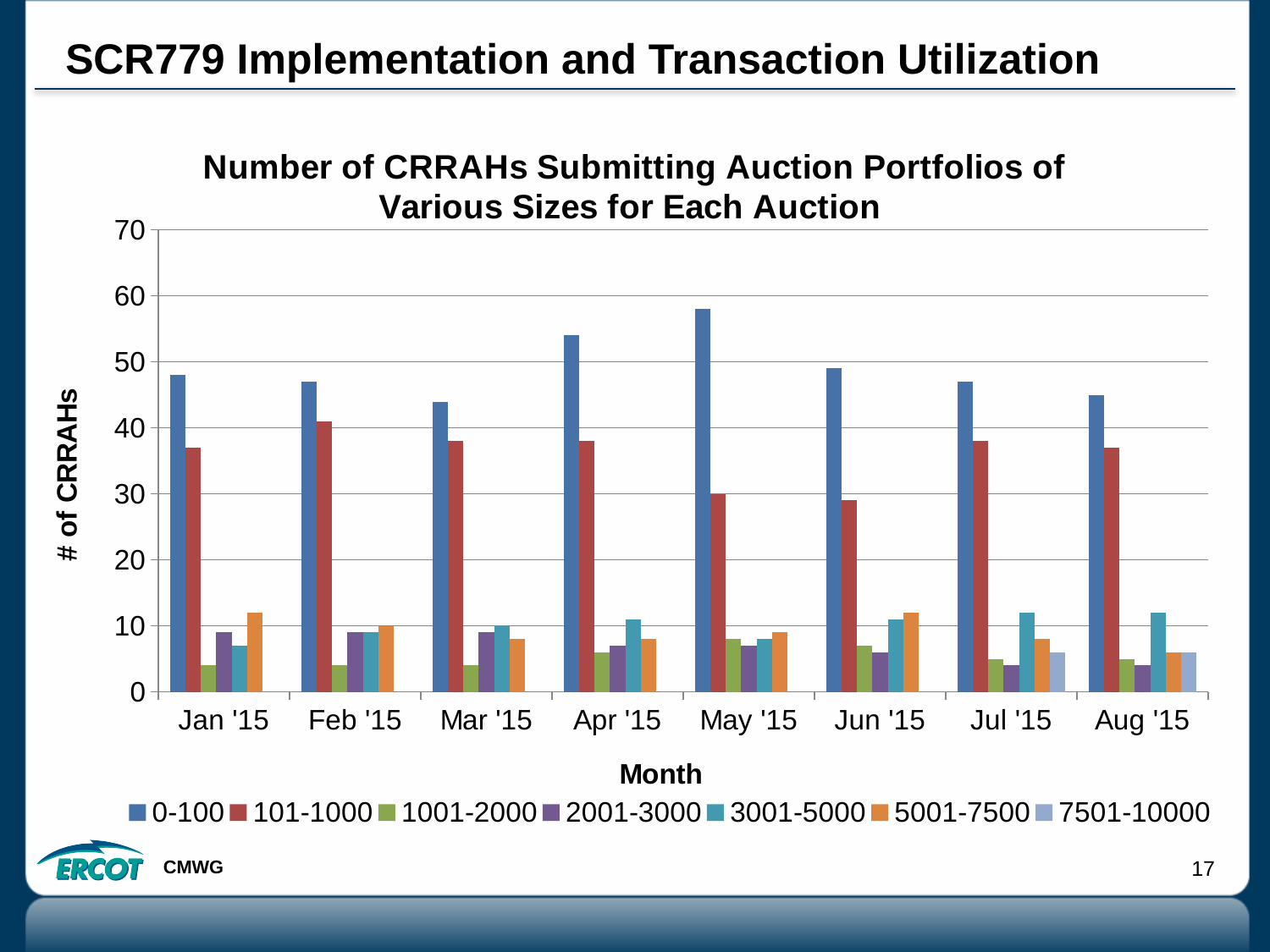
Is the value for the 0-100 series in Mar '15 greater or less than 50? less Is the value for the 0-100 series in May '15 greater or less than 50? greater How many series does the legend list? 7 What is the label on the y axis of the chart? # of CRRAHs How many months are shown on the x axis of the chart? 8 What kind of chart is shown on the slide? bar chart In which month is the value for the 101-1000 series highest? Feb '15 Is the value for the 5001-7500 series in Jan '15 greater or less than 10? greater In May '15, which series has the larger value: 0-100 or 101-1000? 0-100 In which month is the value for the 0-100 series highest? May '15 In Jul '15, which series has the larger value: 3001-5000 or 1001-2000? 3001-5000